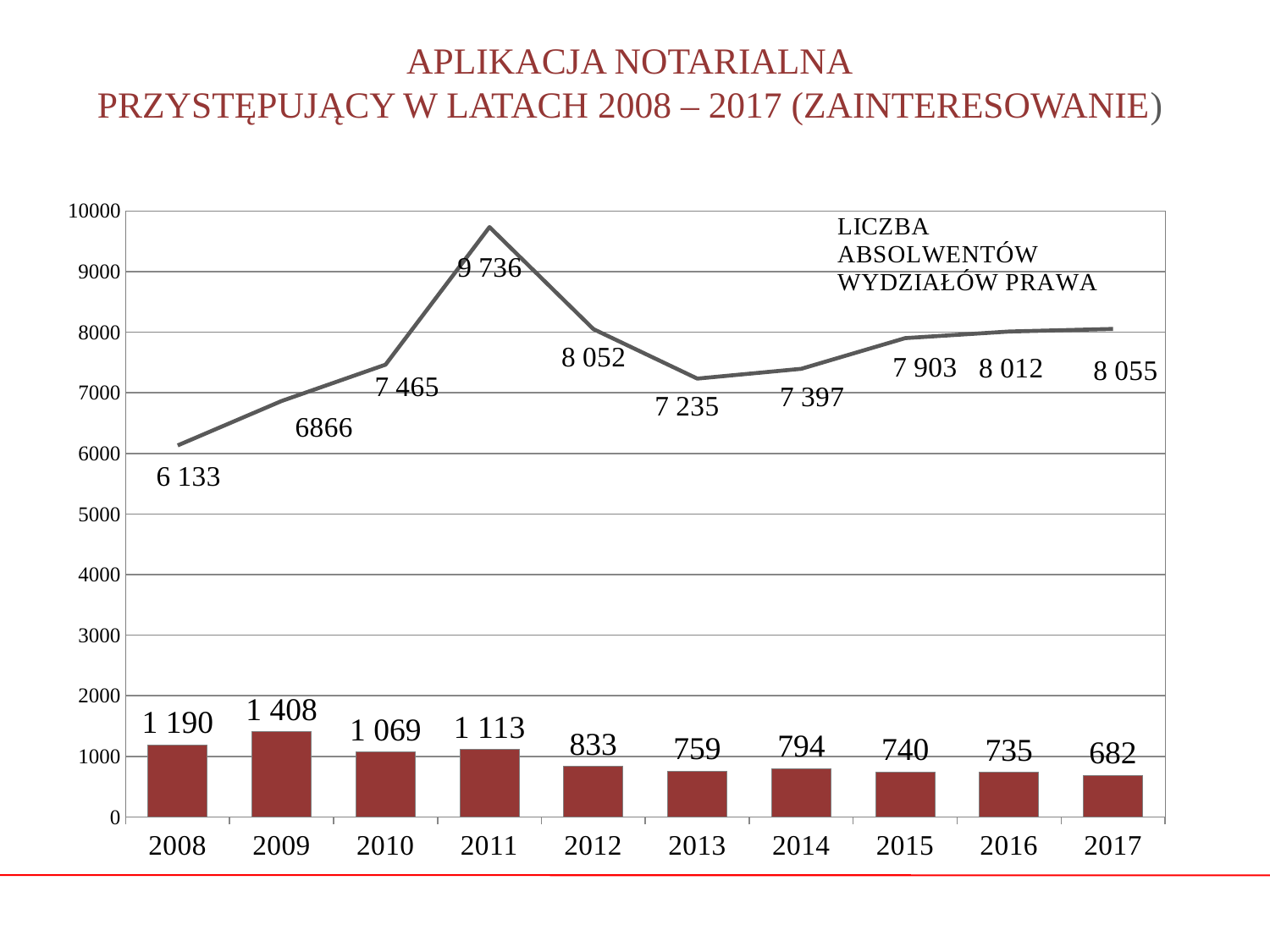
Which year has the lowest bar value? 2017 What is the value of the bar for 2009? 1 408 How many years are shown on the x axis? 10 What is the value of the line (LICZBA ABSOLWENTÓW WYDZIAŁÓW PRAWA) for 2011? 9 736 Do the bar values generally rise or fall from 2011 to 2017? fall What is the difference between the bar values for 2009 and 2017? 726 What is the value of the bar for 2017? 682 Which is larger, the bar value for 2013 or the bar value for 2014? 2014 What is the value of the line (LICZBA ABSOLWENTÓW WYDZIAŁÓW PRAWA) for 2008? 6 133 Is the line value for 2012 greater or less than 8000? greater Which year has the highest bar value? 2009 In which year does the line (LICZBA ABSOLWENTÓW WYDZIAŁÓW PRAWA) reach its highest value? 2011